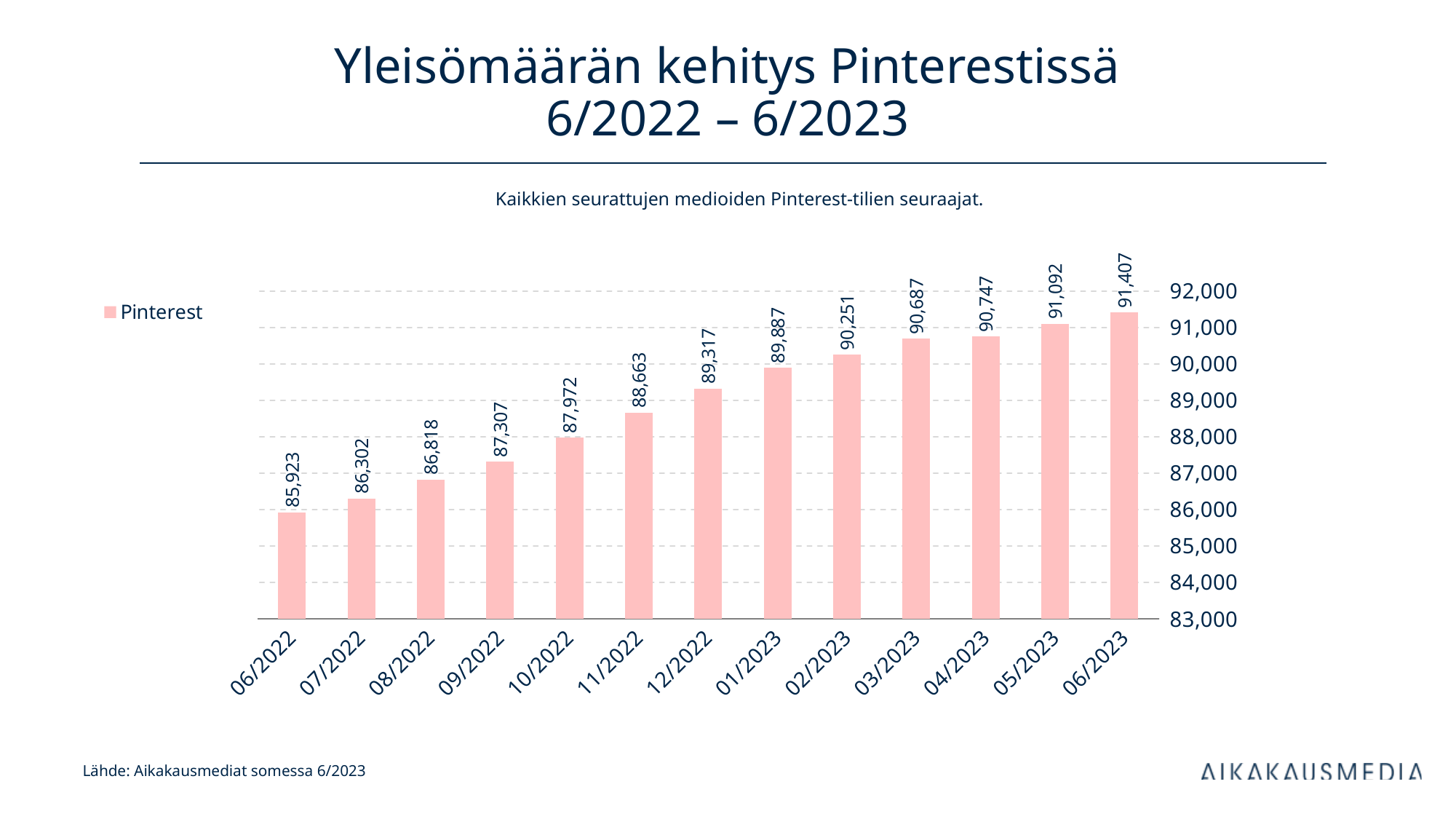
What is the difference between the values for 06/2023 and 06/2022? 5,484 Do the values rise or fall from 06/2022 to 06/2023? rise What is the difference between the values for 11/2022 and 10/2022? 691 Is the value for 08/2022 greater or less than 87,000? less What is the value for 03/2023? 90,687 Which month has the lowest value? 06/2022 What kind of chart is shown on the slide? bar chart What is the value for 12/2022? 89,317 What is the value for 06/2022? 85,923 How many months are shown on the x axis? 13 Which is larger, the value for 09/2022 or the value for 01/2023? 01/2023 Which month has the highest value? 06/2023